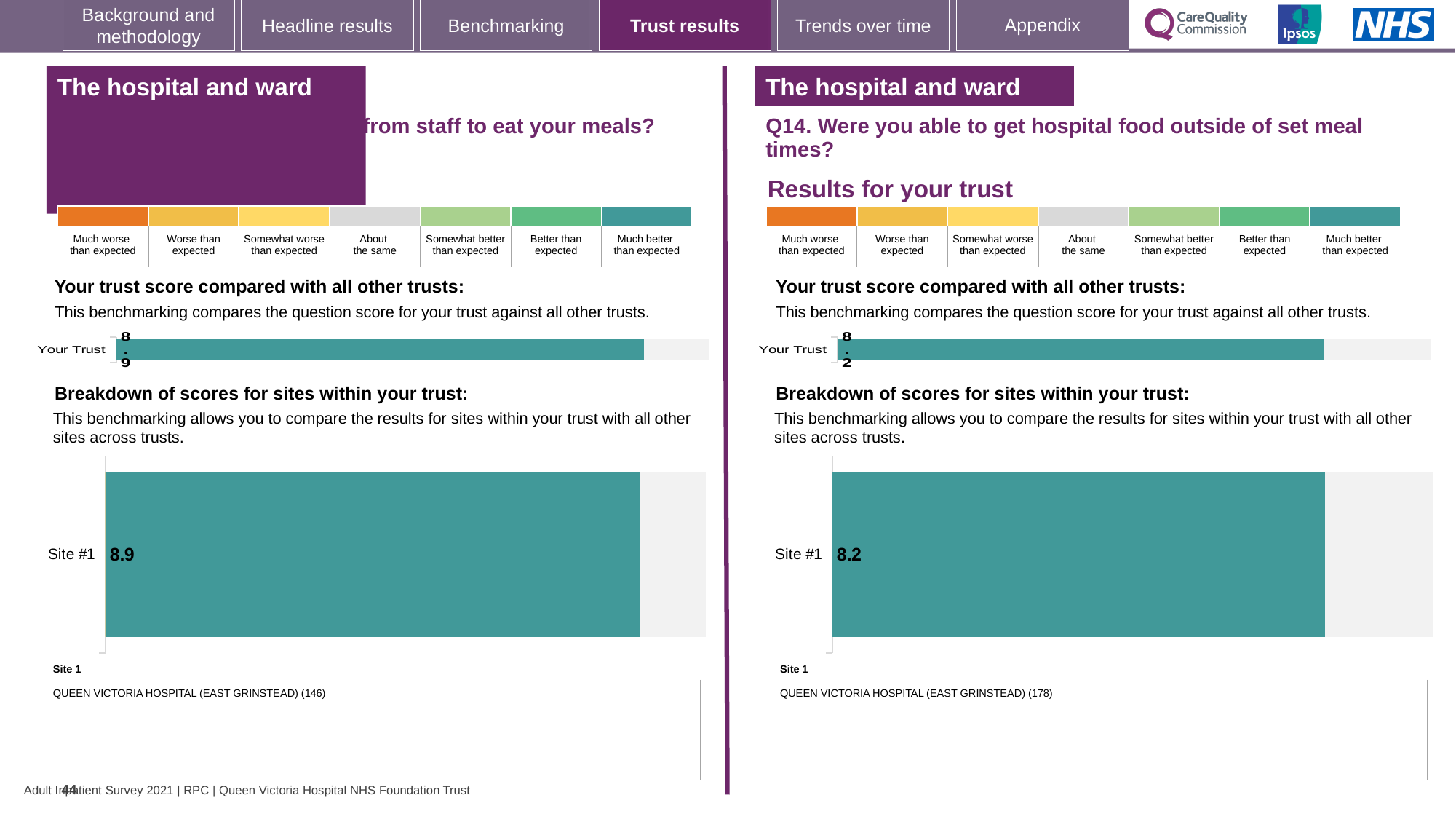
In the 'Breakdown of scores for sites within your trust' chart on the right-hand side (Q14), what is the score for Site #1? 8.2 Which is larger: the Site #1 score in the left-hand breakdown chart or the Site #1 score in the right-hand (Q14) breakdown chart? Left-hand chart (8.9) How many sites are shown in the 'Breakdown of scores for sites within your trust' chart on the left-hand side? 1 In the 'Breakdown of scores for sites within your trust' chart on the left-hand side, what is the score for Site #1? 8.9 What colour is the bar for Your Trust in the right-hand (Q14) 'Your trust score compared with all other trusts' chart? Teal Is the Your Trust score in the right-hand (Q14) 'Your trust score compared with all other trusts' chart greater or less than the Your Trust score in the left-hand chart? Less What type of chart is used to show the Site #1 score in the 'Breakdown of scores for sites within your trust' section on the right-hand side? Bar chart How many sites are shown in the 'Breakdown of scores for sites within your trust' chart on the right-hand side (Q14)? 1 What is the name of the site listed as Site 1 below the right-hand (Q14) breakdown chart? QUEEN VICTORIA HOSPITAL (EAST GRINSTEAD) (178) On the right-hand side of the slide (Q14), what is the score shown for Your Trust in the 'Your trust score compared with all other trusts' chart? 8.2 What is the difference between the Site #1 score on the left-hand breakdown chart and the Site #1 score on the right-hand (Q14) breakdown chart? 0.7 On the left-hand side of the slide, what is the score shown for Your Trust in the 'Your trust score compared with all other trusts' chart? 8.9